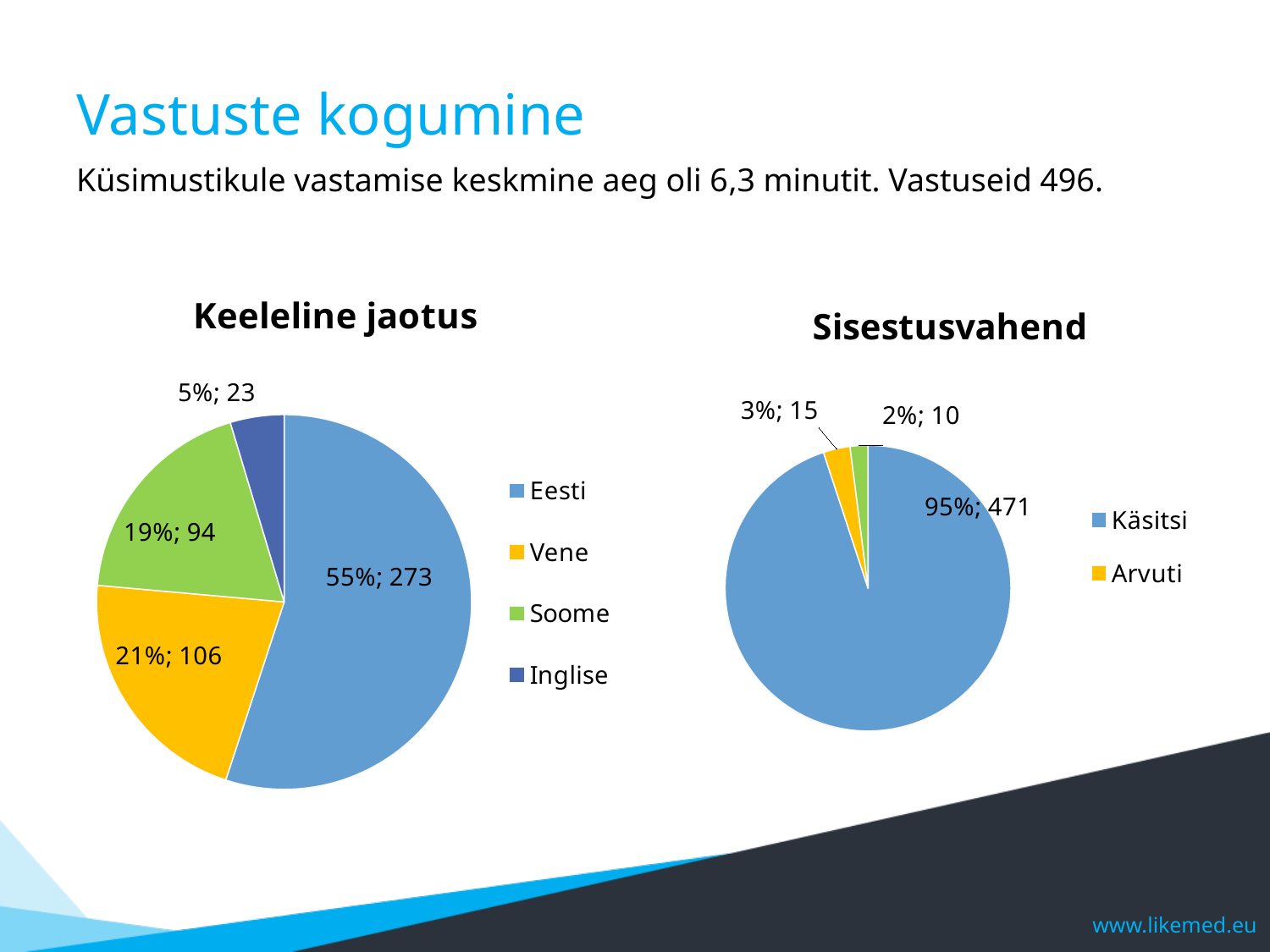
In the 'Sisestusvahend' chart, how many responses are shown for Arvuti? 15 In the 'Keeleline jaotus' chart, what is the data label for Eesti? 55%; 273 In the 'Sisestusvahend' chart, which is larger, Käsitsi or Arvuti? Käsitsi In the 'Sisestusvahend' chart, how many entries does the legend list? 2 In the 'Keeleline jaotus' chart, which category has the largest slice? Eesti In the 'Keeleline jaotus' chart, what is the difference in count between Vene and Soome? 12 In the 'Keeleline jaotus' chart, how many responses are shown for Vene? 106 In the 'Sisestusvahend' chart, what is the data label for Käsitsi? 95%; 471 In the 'Keeleline jaotus' chart, what percentage share does Soome have? 19% In the 'Keeleline jaotus' chart, which category has the smallest slice? Inglise What type of chart is 'Sisestusvahend'? Pie chart In the 'Keeleline jaotus' chart, how many categories does the legend list? 4